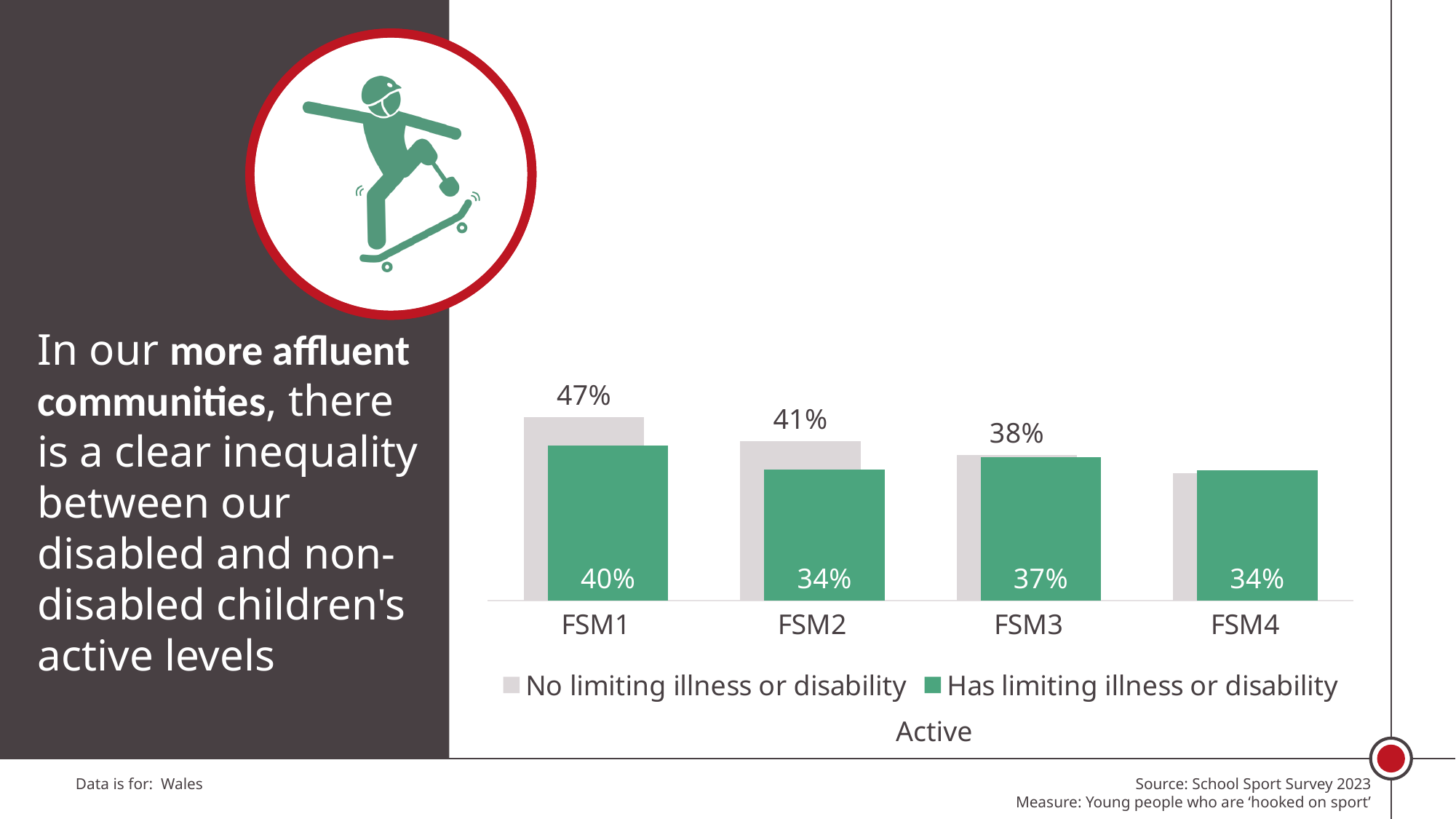
What is the value for FSM1 in the 'No limiting illness or disability' series? 47% What is the value for FSM4 in the 'Has limiting illness or disability' series? 34% Do the values in the 'No limiting illness or disability' series rise or fall from FSM1 to FSM4? fall For FSM1, which series has the larger value: 'No limiting illness or disability' or 'Has limiting illness or disability'? No limiting illness or disability What is the difference between the 'No limiting illness or disability' and 'Has limiting illness or disability' values for FSM1? 7 percentage points What is the value for FSM3 in the 'No limiting illness or disability' series? 38% What is the value for FSM2 in the 'Has limiting illness or disability' series? 34% How many categories are shown on the x axis of the chart? 4 Which category has the highest value in the 'Has limiting illness or disability' series? FSM1 How many series does the chart's legend list? 2 Which category has the lowest value in the 'No limiting illness or disability' series? FSM4 What is the difference between the 'No limiting illness or disability' and 'Has limiting illness or disability' values for FSM2? 7 percentage points